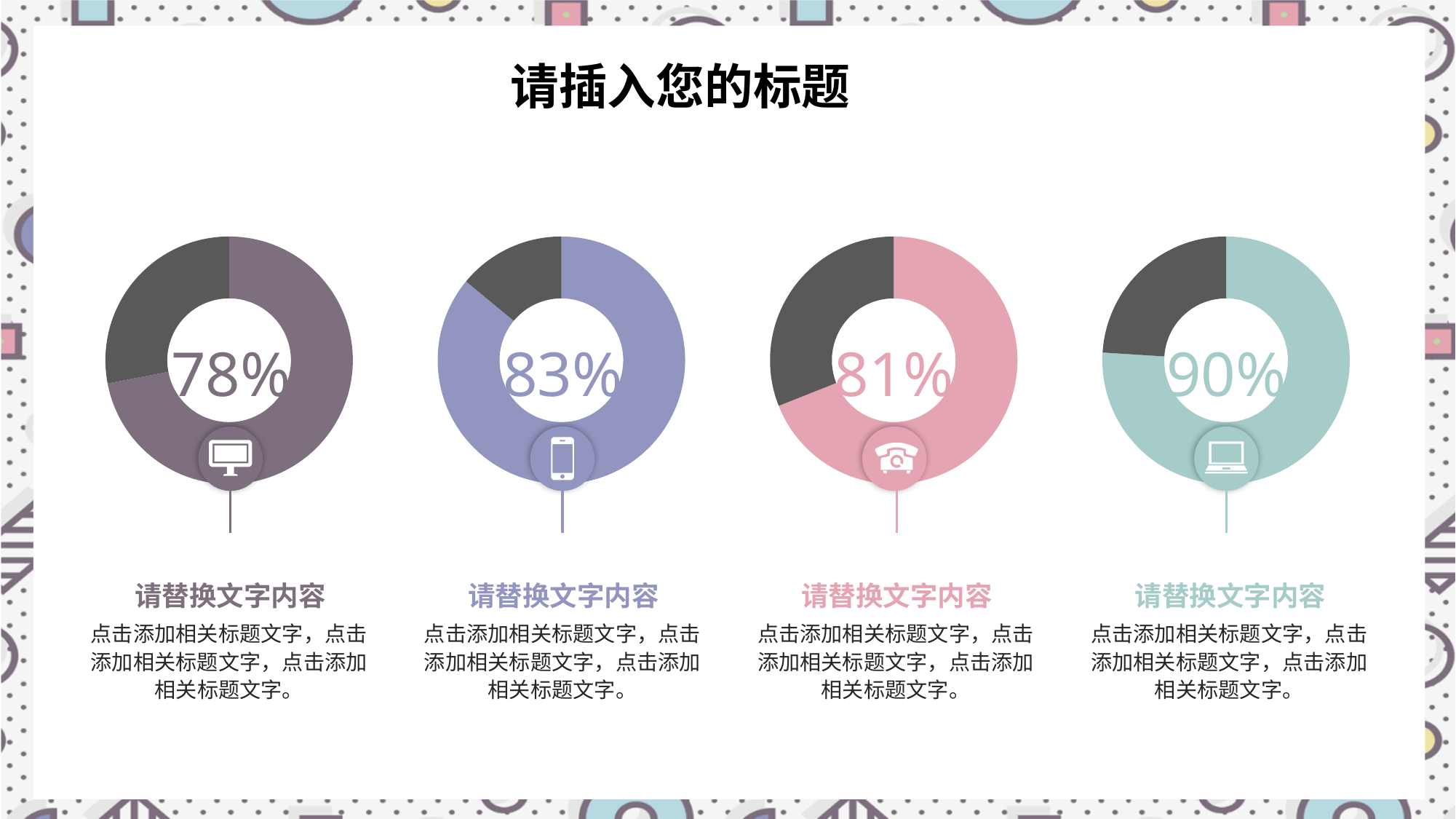
What is the difference between the percentages in the second and third donut charts? 2% Which is larger, the percentage in the second donut chart or the percentage in the third donut chart? The second (83%) Which donut chart shows the highest percentage? The rightmost (90%) What percentage is shown in the leftmost donut chart? 78% What colour is the filled portion of the rightmost donut chart? Teal What is the difference between the percentage in the rightmost donut chart and the percentage in the leftmost donut chart? 12% Which donut chart shows the lowest percentage? The leftmost (78%) What percentage is shown in the rightmost donut chart? 90% What kind of chart is used to display the percentages on the slide? Donut chart What percentage is shown in the second donut chart from the left? 83% How many donut charts are on the slide? 4 What percentage is shown in the third donut chart from the left? 81%